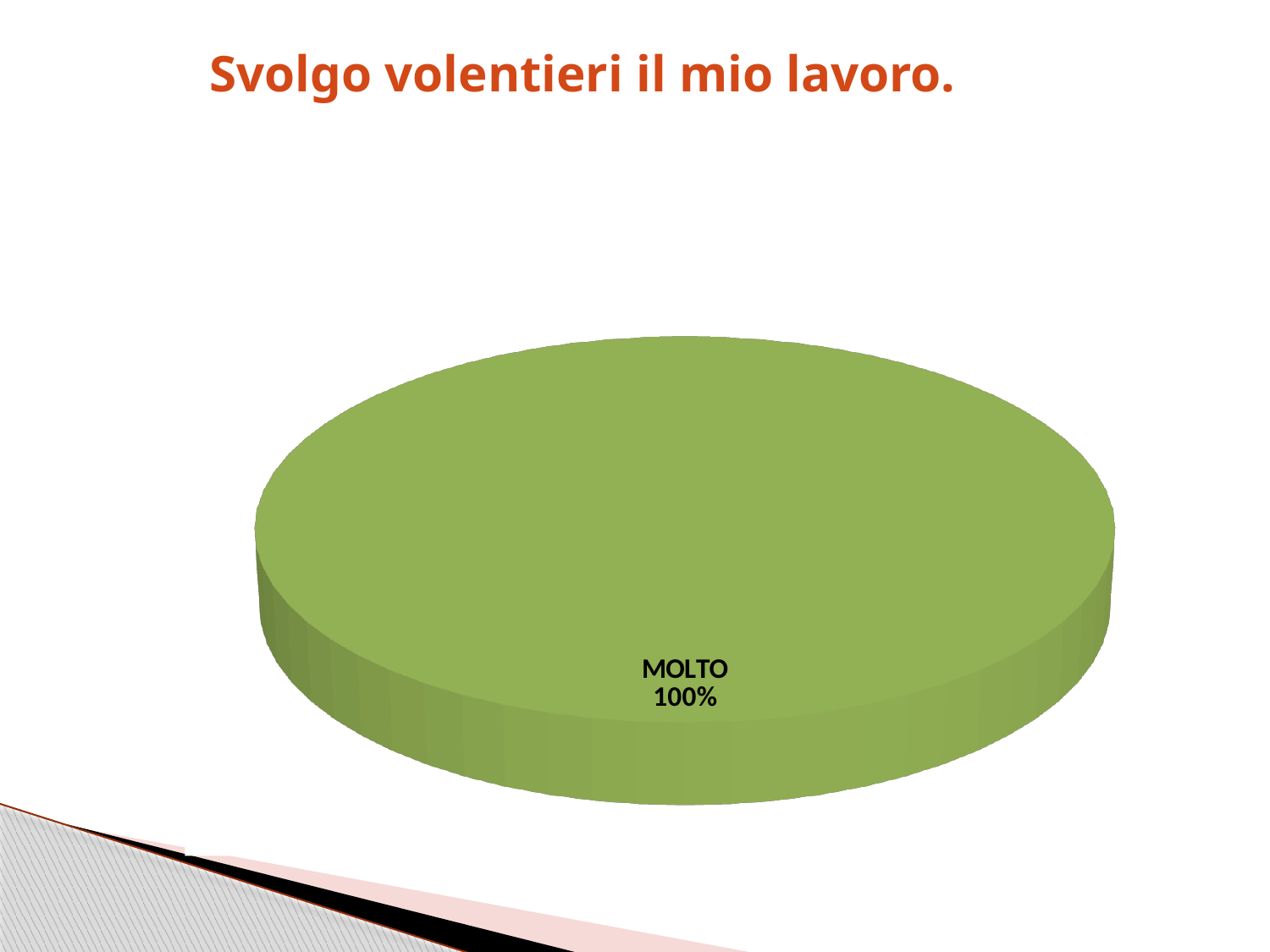
What kind of chart is shown on the slide? pie chart What is the title of the slide above the pie chart? Svolgo volentieri il mio lavoro. Which category has the largest share of the pie chart? MOLTO What share of the pie does the MOLTO slice represent? 100% What colour is the MOLTO slice of the pie chart? green What is the label of the only slice in the pie chart? MOLTO How many slices does the pie chart have? 1